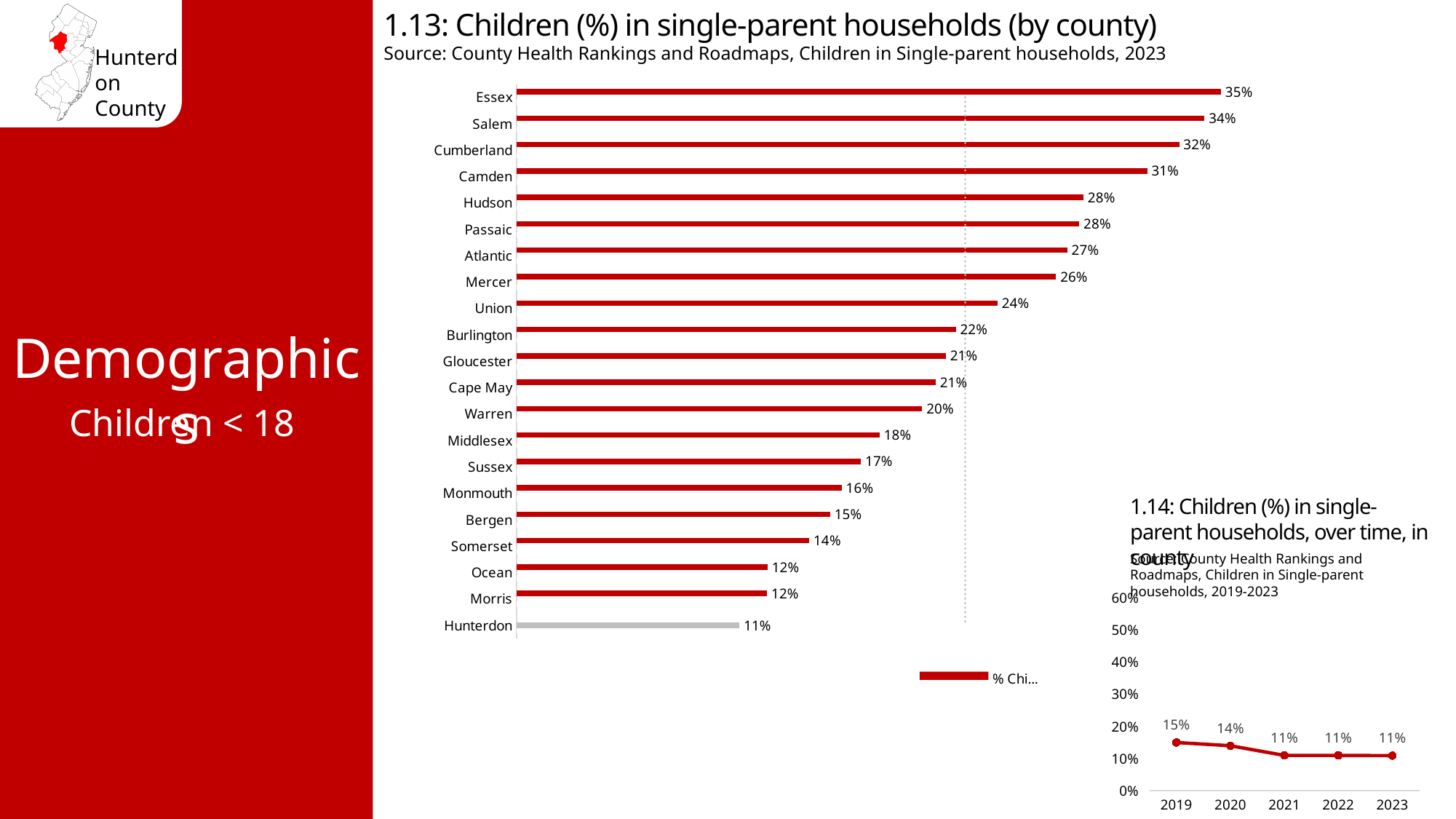
In chart 1.13 (Children in single-parent households by county), what is the value for Essex? 35% In chart 1.13 (Children in single-parent households by county), how many counties are shown? 21 What kind of chart is chart 1.13 (Children in single-parent households by county)? Bar chart In chart 1.13 (Children in single-parent households by county), which county has the highest value? Essex In chart 1.14 (Children in single-parent households over time, in county), how many years are plotted? 5 In chart 1.13 (Children in single-parent households by county), what is the difference between Essex and Hunterdon? 24% In chart 1.13 (Children in single-parent households by county), what is the value for Hunterdon? 11% In chart 1.13 (Children in single-parent households by county), which is larger, the value for Camden or the value for Union? Camden In chart 1.14 (Children in single-parent households over time, in county), what is the value for 2019? 15% In chart 1.14 (Children in single-parent households over time, in county), do the values rise or fall from 2019 to 2023? Fall In chart 1.14 (Children in single-parent households over time, in county), what is the value for 2023? 11% In chart 1.13 (Children in single-parent households by county), which county has the lowest value? Hunterdon